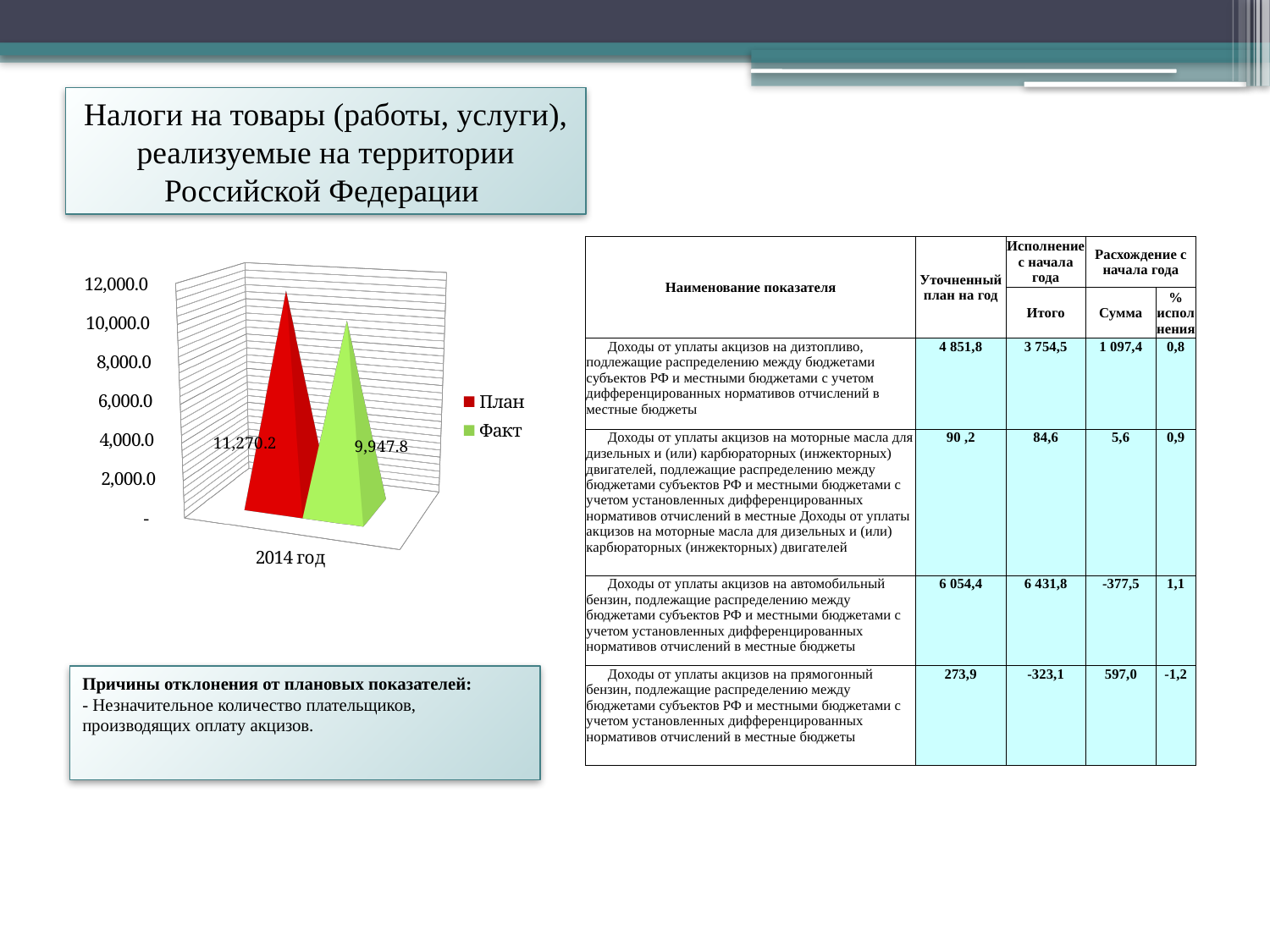
What is the value of the Факт series for 2014 год? 9,947.8 Is the value for План greater or less than 10,000.0? greater What colour represents the Факт series in the chart? green Is the value for Факт greater or less than 10,000.0? less What kind of chart is shown on the slide? bar chart Which series shows the highest value on the chart? План What is the value of the План series for 2014 год? 11,270.2 Which series shows the lowest value on the chart? Факт How many series does the chart legend list? 2 How many categories are shown on the x axis of the chart? 1 What is the difference between the План and Факт values for 2014 год? 1,322.4 Which series has the higher value for 2014 год, План or Факт? План